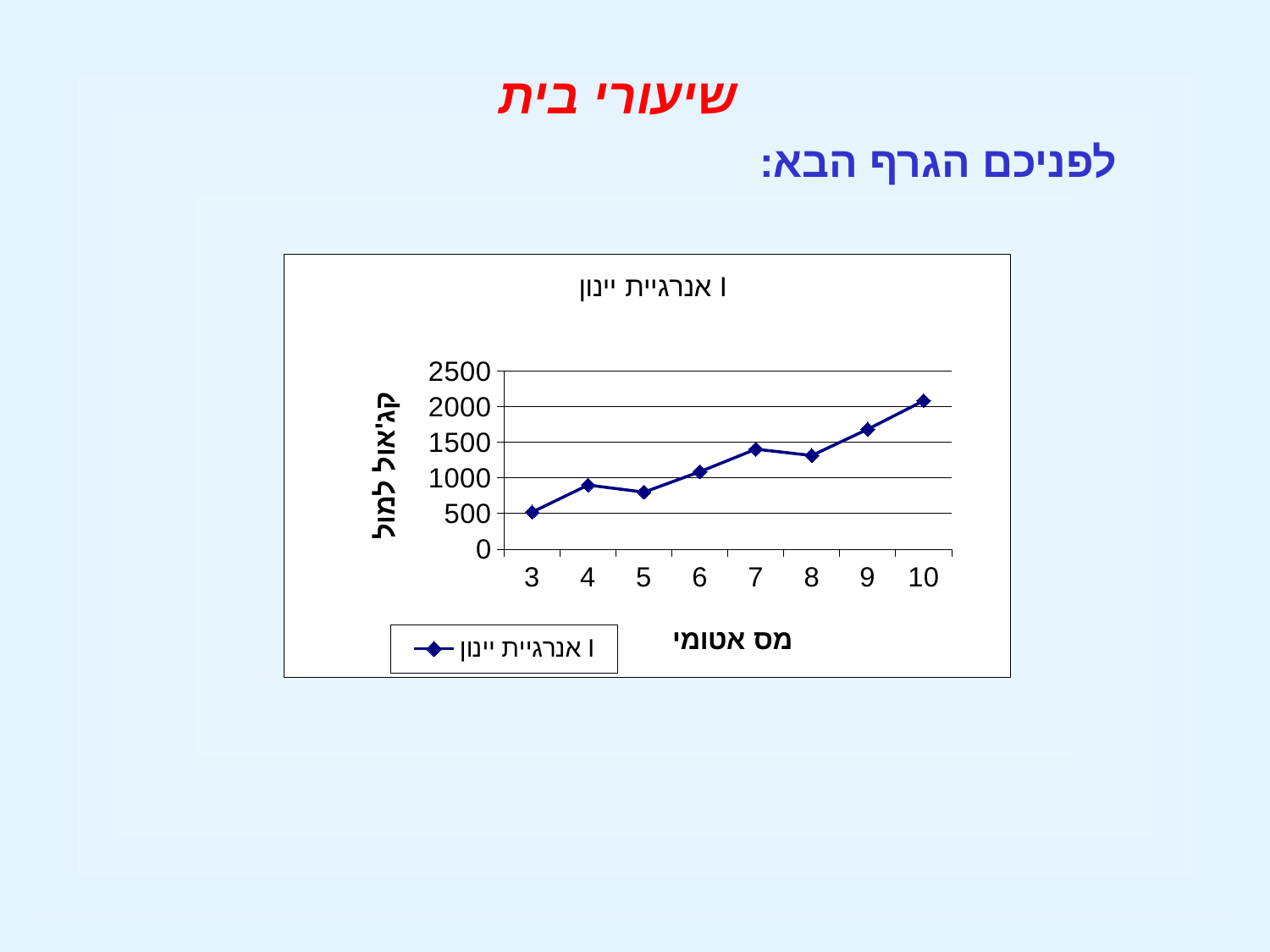
How many data points are plotted on the chart? 8 What is the label on the y axis of the chart? קג'אול למול What is the label on the x axis of the chart? מס אטומי Is the value for atomic number 3 greater or less than 1000? less Is the value for atomic number 9 greater or less than 1500? greater Which atomic number has the lowest ionization energy on the chart? 3 Which atomic number has the highest ionization energy on the chart? 10 Is the value for atomic number 5 greater or less than 1000? less Overall, do the values rise or fall as the atomic number increases from 3 to 10? rise How many series does the legend list? 1 Which has a larger value, atomic number 6 or atomic number 9? 9 What kind of chart is shown on the slide? line chart